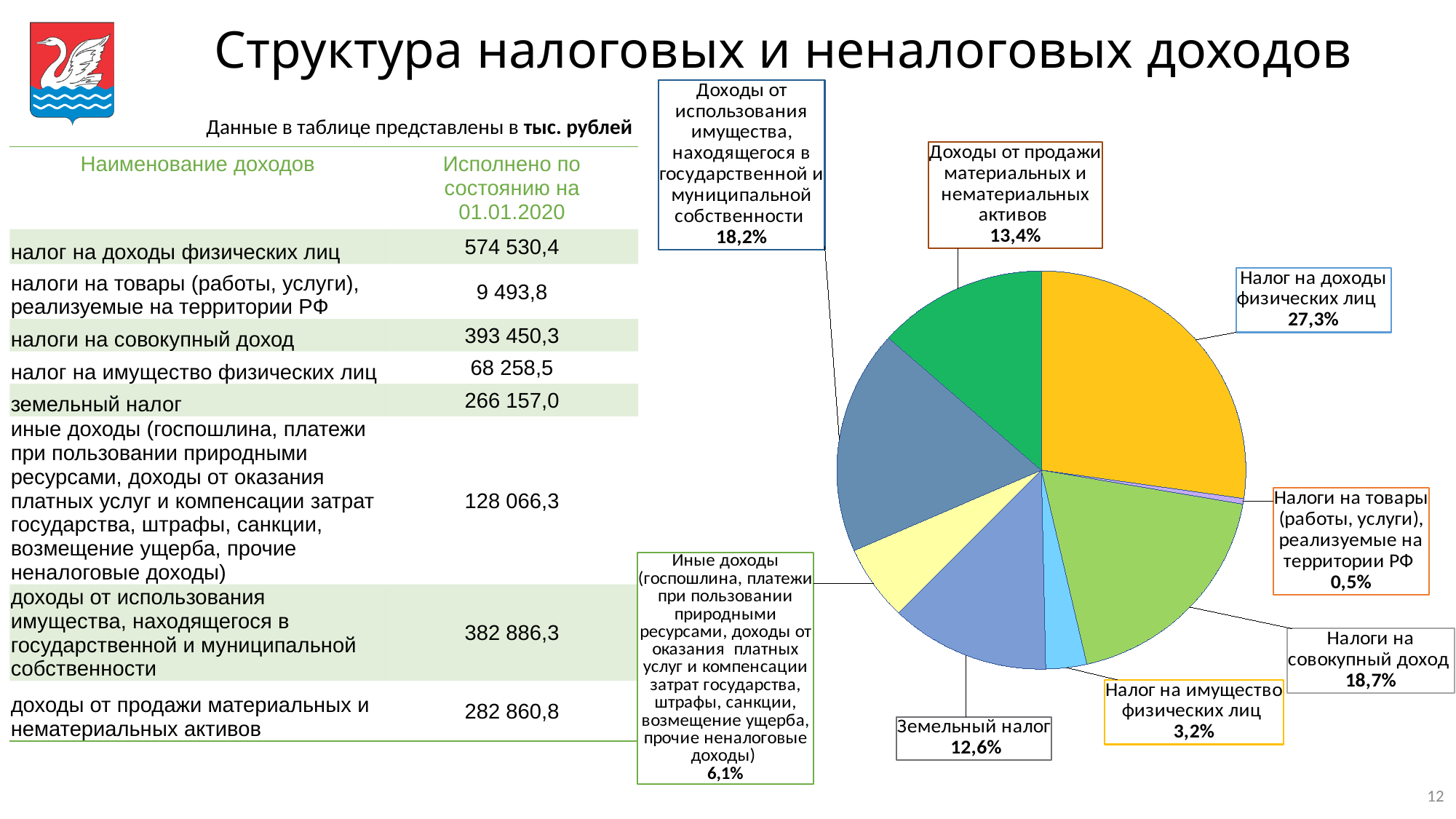
What is the title of the slide containing the pie chart? Структура налоговых и неналоговых доходов Which is larger: the share of "Налоги на совокупный доход" or the share of "Доходы от использования имущества, находящегося в государственной и муниципальной собственности"? Налоги на совокупный доход Which slice of the pie chart is the largest? Налог на доходы физических лиц What share of the pie does "Налоги на совокупный доход" have? 18,7% What share of the pie does "Налог на доходы физических лиц" have? 27,3% What is the difference in percentage points between "Налог на доходы физических лиц" and "Налоги на совокупный доход"? 8,6 What share of the pie does "Налог на имущество физических лиц" have? 3,2% How many slices does the pie chart have? 8 What kind of chart is shown on the slide? pie chart Which slice of the pie chart is the smallest? Налоги на товары (работы, услуги), реализуемые на территории РФ